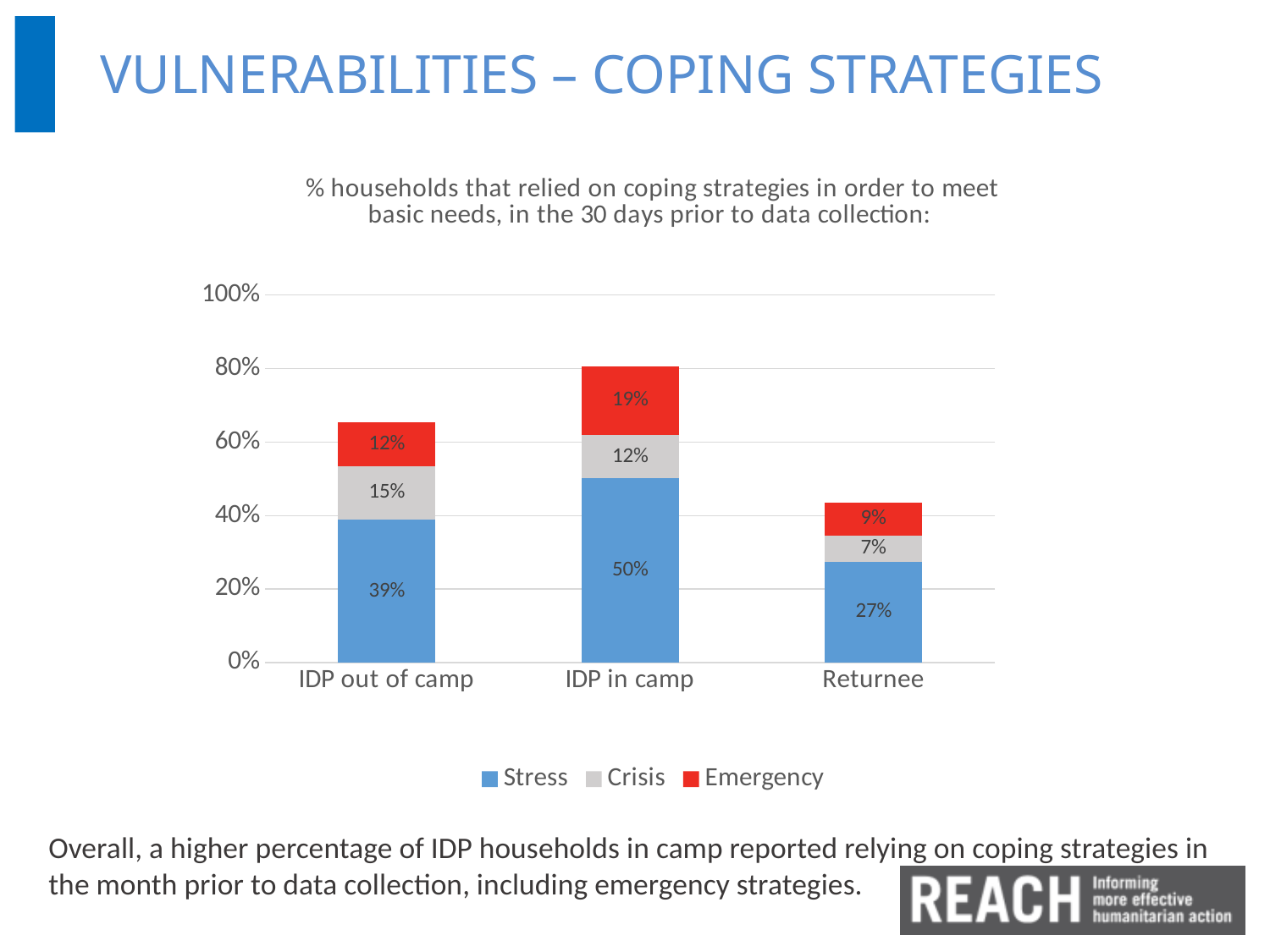
How many categories are shown on the x axis? 3 What kind of chart is shown on the slide? Stacked bar chart What is the total of the stacked bar for IDP in camp? 81% What is the difference between the Stress values for IDP in camp and Returnee? 23% What is the total of the stacked bar for Returnee? 43% What is the Crisis value for IDP out of camp? 15% Which category has the lowest Emergency value? Returnee What is the Stress value for IDP in camp? 50% Which is larger, the Crisis value for IDP out of camp or the Crisis value for IDP in camp? IDP out of camp Which category has the highest Stress value? IDP in camp How many series does the legend list? 3 What is the Emergency value for Returnee? 9%